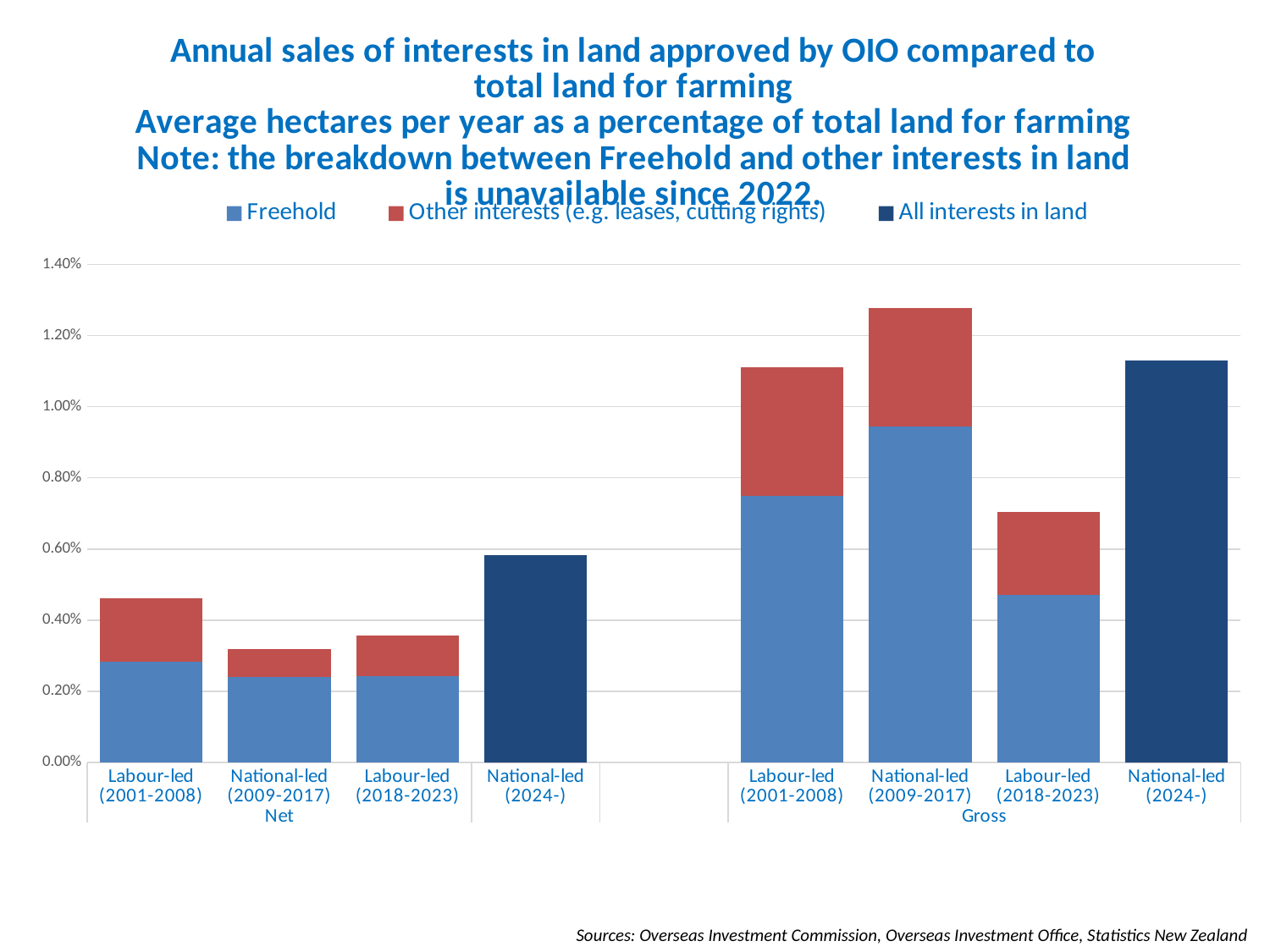
Which bar is the tallest in the chart? National-led (2009-2017) in the Gross group Is the value for National-led (2024-) in the Gross group greater or less than 1.00%? greater Is the Freehold segment for National-led (2009-2017) in the Gross group greater or less than 0.80%? greater How many bars are plotted in the chart? 8 In the Gross group, which total bar is larger: Labour-led (2001-2008) or Labour-led (2018-2023)? Labour-led (2001-2008) In the Net group, which is larger: the bar for National-led (2024-) or the total bar for Labour-led (2001-2008)? National-led (2024-) Is the value for National-led (2024-) in the Net group greater or less than 0.40%? greater What kind of chart is shown on the slide? Bar chart How many series does the legend list? 3 What are the two group labels shown beneath the x axis? Net and Gross Within the Gross group, which category has the lowest total bar? Labour-led (2018-2023)